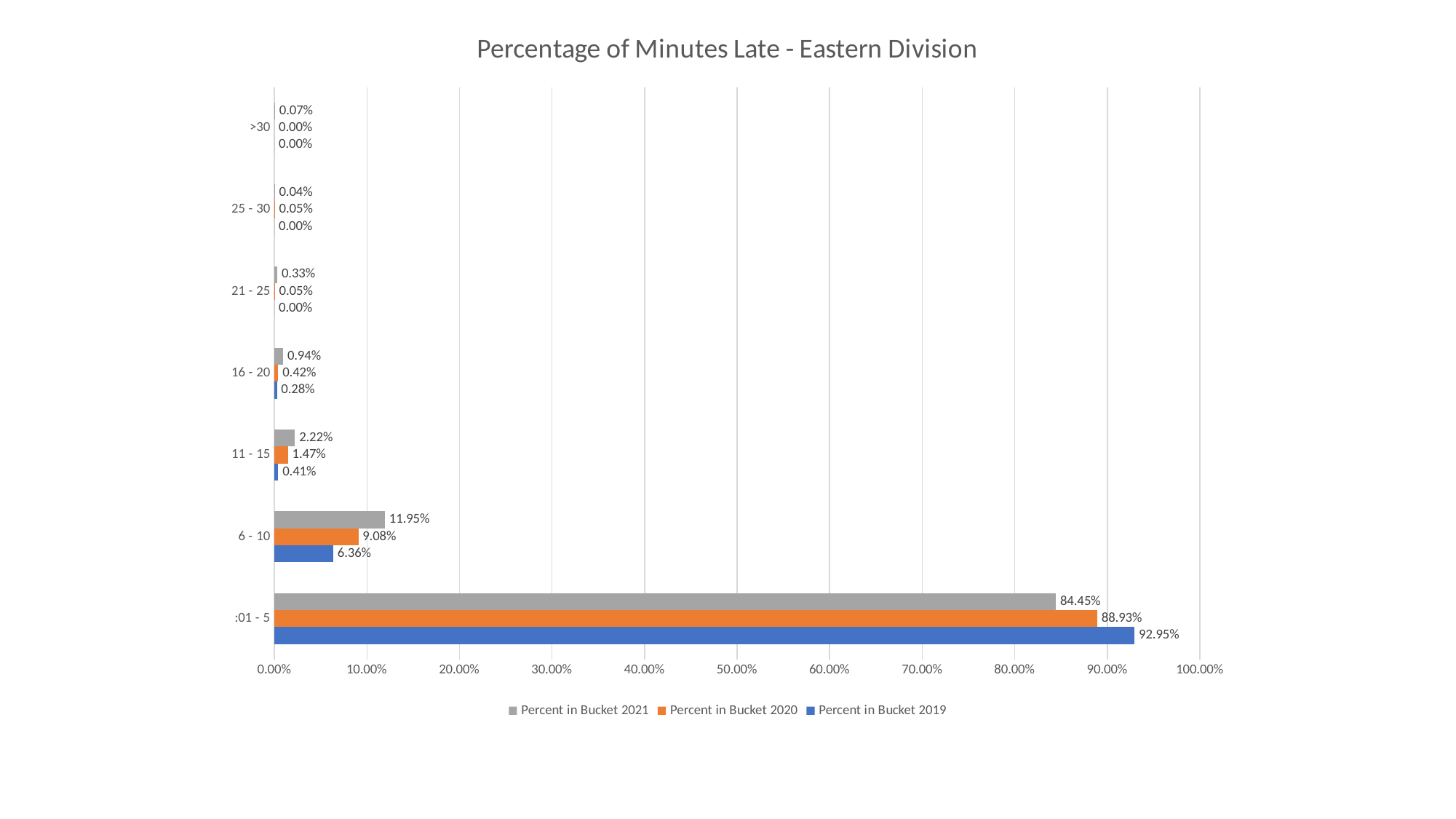
What kind of chart is shown on the slide? Bar chart What is the difference between Percent in Bucket 2019 and Percent in Bucket 2021 in the :01 - 5 category? 8.50% What is the title of the chart? Percentage of Minutes Late - Eastern Division Which series has the lowest value in the :01 - 5 category? Percent in Bucket 2021 What is the value for Percent in Bucket 2020 in the 11 - 15 category? 1.47% How many series does the legend list? 3 Which category has the highest value for Percent in Bucket 2020? :01 - 5 What is the value for Percent in Bucket 2021 in the >30 category? 0.07% How many categories are shown on the y axis? 7 What is the value for Percent in Bucket 2019 in the :01 - 5 category? 92.95% In the 6 - 10 category, which is larger: Percent in Bucket 2020 or Percent in Bucket 2019? Percent in Bucket 2020 What is the value for Percent in Bucket 2021 in the 6 - 10 category? 11.95%